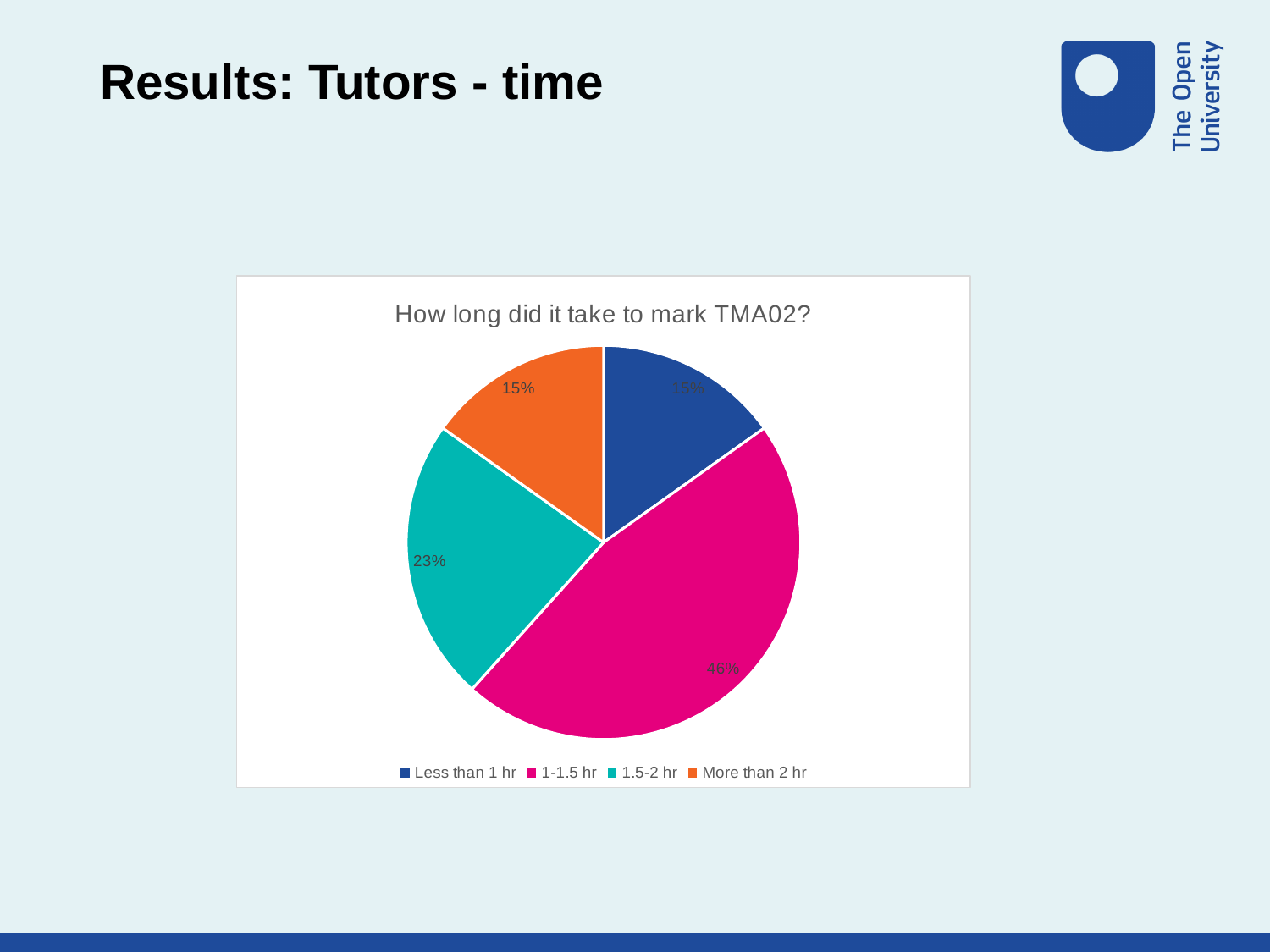
What type of chart is shown on the slide? pie chart Is the share for 1-1.5 hr greater or less than 50%? less What share of the pie is the 1.5-2 hr slice? 23% Which category has the largest slice of the pie? 1-1.5 hr What share of the pie is the 1-1.5 hr slice? 46% What share of the pie is the Less than 1 hr slice? 15% Which is larger, the 1.5-2 hr slice or the More than 2 hr slice? 1.5-2 hr How many categories does the legend list? 4 What is the difference between the 1-1.5 hr share and the 1.5-2 hr share? 23% What colour is the 1-1.5 hr slice? magenta (pink) What is the title of the chart? How long did it take to mark TMA02?